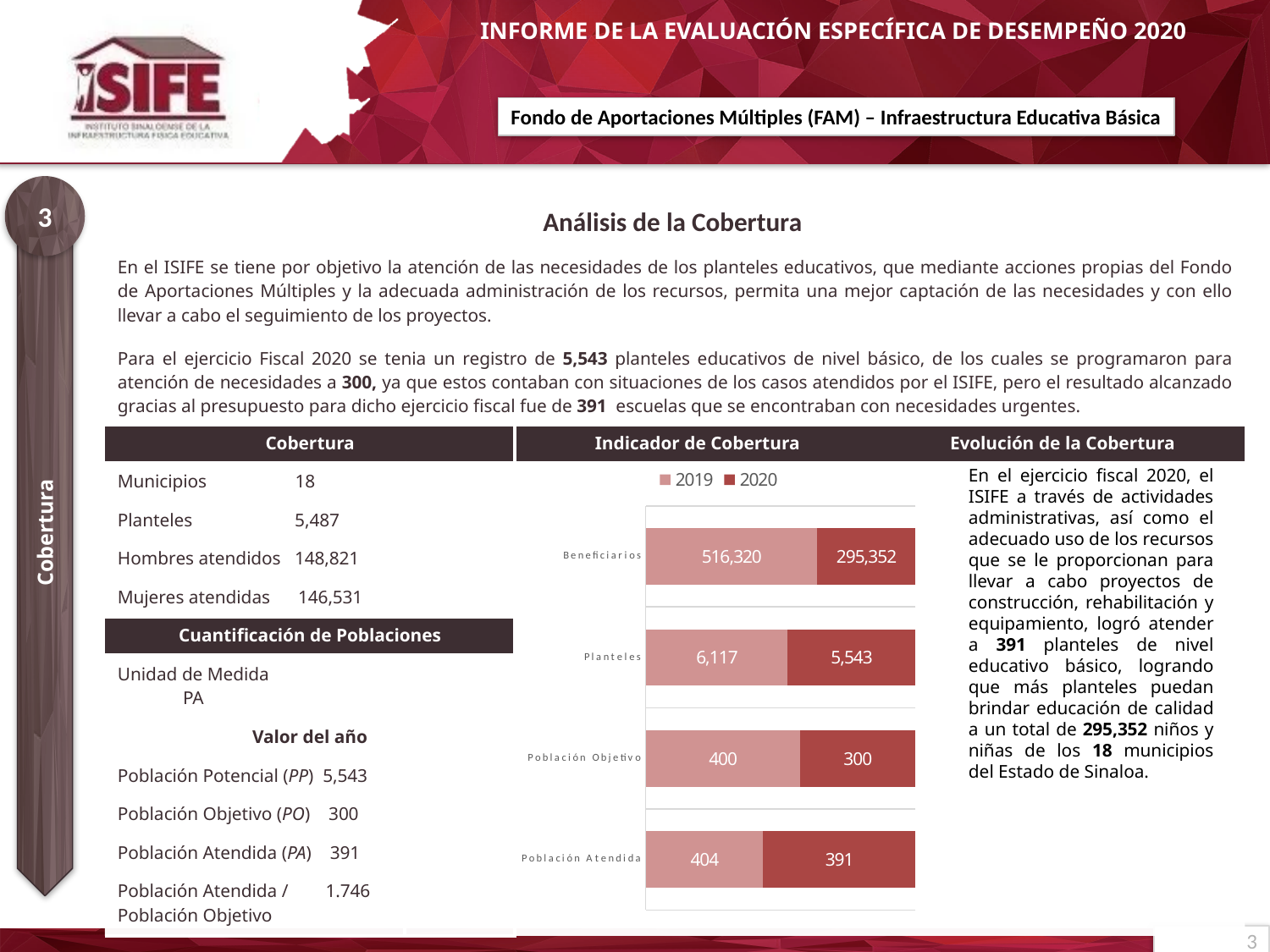
In the 'Indicador de Cobertura' chart, what is the difference between the 2019 and 2020 values for Población Atendida? 13 In the 'Indicador de Cobertura' chart, what is the 2019 value for Población Objetivo? 400 In the 'Indicador de Cobertura' chart, what is the difference between the 2019 and 2020 values for Planteles? 574 In the 'Indicador de Cobertura' chart, which category has the lowest 2019 value? Población Objetivo In the 'Indicador de Cobertura' chart, what is the 2020 value for Población Atendida? 391 In the 'Indicador de Cobertura' chart, which is larger for Beneficiarios: the 2019 value or the 2020 value? 2019 What kind of chart is the 'Indicador de Cobertura' chart? Stacked bar chart In the 'Indicador de Cobertura' chart, what is the 2020 value for Planteles? 5,543 How many series does the legend of the 'Indicador de Cobertura' chart list? 2 How many categories are shown in the 'Indicador de Cobertura' chart? 4 In the 'Indicador de Cobertura' chart, what is the 2019 value for Beneficiarios? 516,320 In the 'Indicador de Cobertura' chart, which category has the highest 2020 value? Beneficiarios